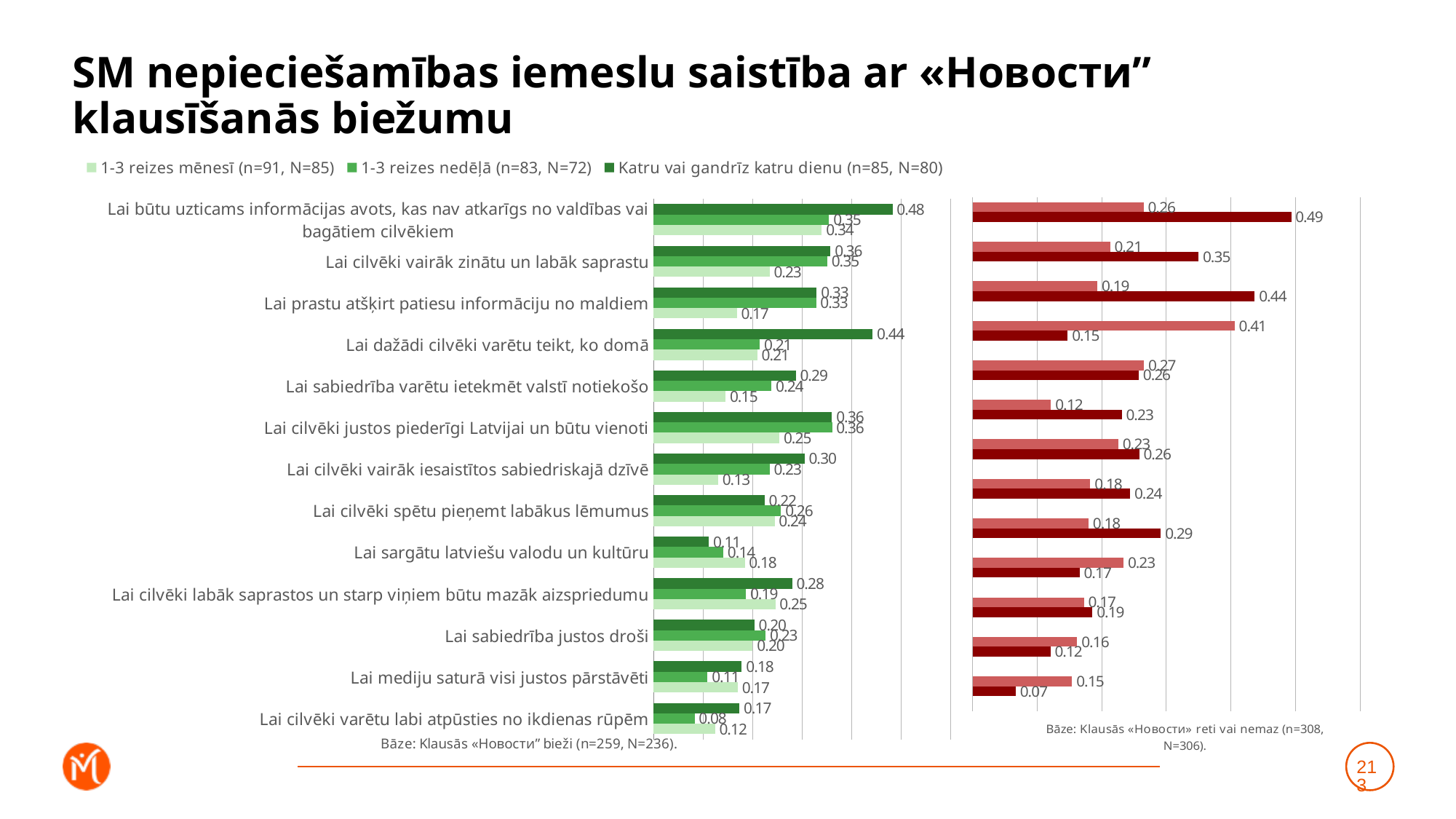
How many categories are shown in the left (green) chart? 13 In the left (green) chart, for 'Lai sargātu latviešu valodu un kultūru', which series has the larger value: '1-3 reizes mēnesī' or 'Katru vai gandrīz katru dienu'? 1-3 reizes mēnesī In the right (red) chart, what is the value of the light red bar for 'Lai dažādi cilvēki varētu teikt, ko domā'? 0.41 In the left (green) chart, which category has the lowest value for '1-3 reizes nedēļā'? Lai cilvēki varētu labi atpūsties no ikdienas rūpēm What type of chart is used on this slide? Bar chart In the right (red) chart, what is the value of the dark red bar for 'Lai būtu uzticams informācijas avots, kas nav atkarīgs no valdības vai bagātiem cilvēkiem'? 0.49 In the left (green) chart, what is the value for '1-3 reizes nedēļā' for 'Lai cilvēki spētu pieņemt labākus lēmumus'? 0.26 In the left (green) chart, what is the value for 'Katru vai gandrīz katru dienu' for 'Lai būtu uzticams informācijas avots, kas nav atkarīgs no valdības vai bagātiem cilvēkiem'? 0.48 In the left (green) chart, what is the difference between the 'Katru vai gandrīz katru dienu' and '1-3 reizes mēnesī' values for 'Lai dažādi cilvēki varētu teikt, ko domā'? 0.23 In the left (green) chart, what is the value for '1-3 reizes mēnesī' for 'Lai prastu atšķirt patiesu informāciju no maldiem'? 0.17 How many series does the legend of the left (green) chart list? 3 In the left (green) chart, which category has the highest value for 'Katru vai gandrīz katru dienu'? Lai būtu uzticams informācijas avots, kas nav atkarīgs no valdības vai bagātiem cilvēkiem